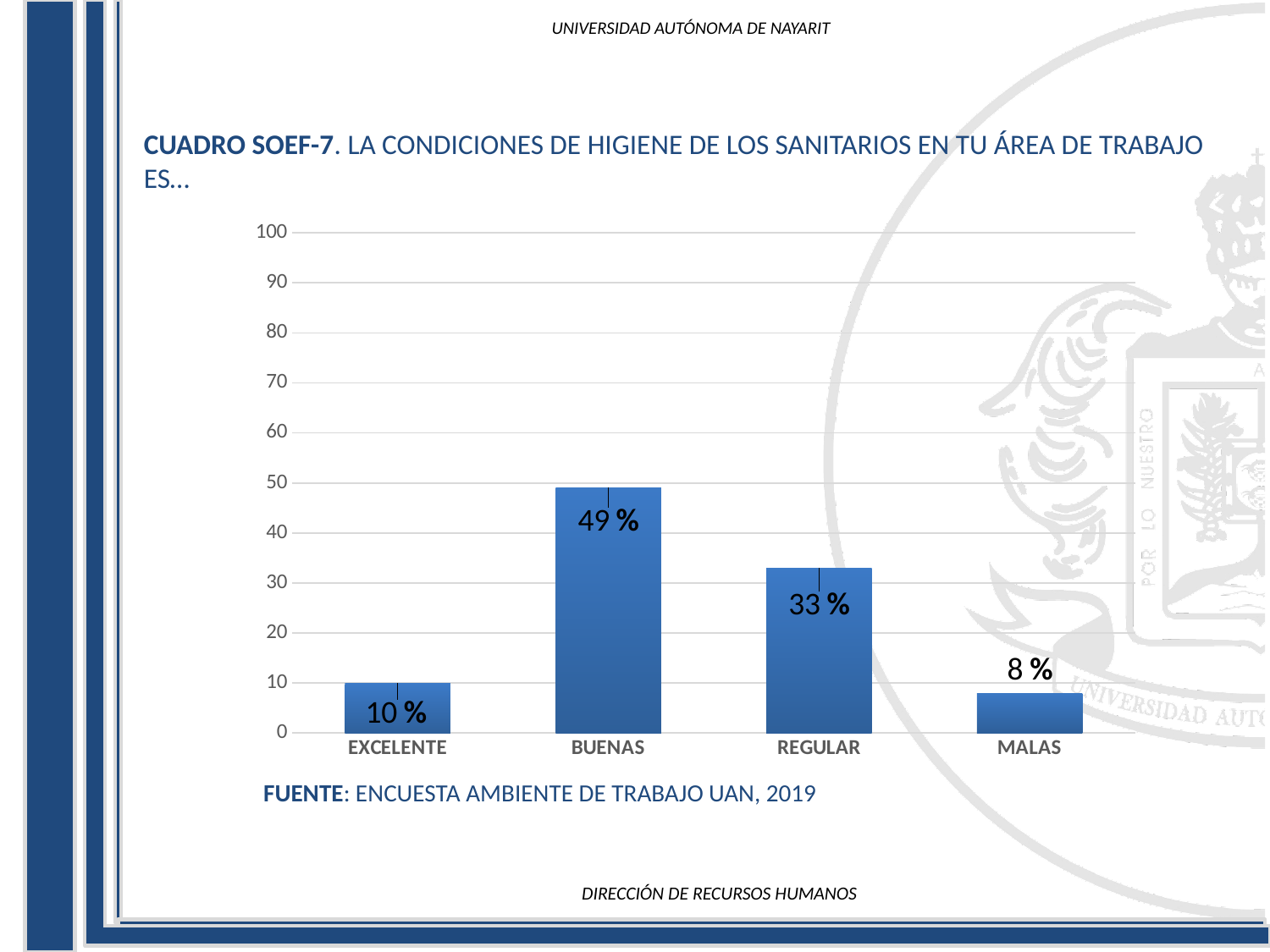
Which category has the highest value? BUENAS What is the difference between the values for BUENAS and REGULAR? 16 % What is the value for EXCELENTE? 10 % Is the value for REGULAR greater or less than 30? greater What is the value for MALAS? 8 % How many categories are shown on the x axis? 4 What kind of chart is shown on the slide? bar chart What is the value for REGULAR? 33 % Which category has the lowest value? MALAS Which is larger, the value for EXCELENTE or the value for MALAS? EXCELENTE What is the value for BUENAS? 49 % What source is cited below the chart? ENCUESTA AMBIENTE DE TRABAJO UAN, 2019